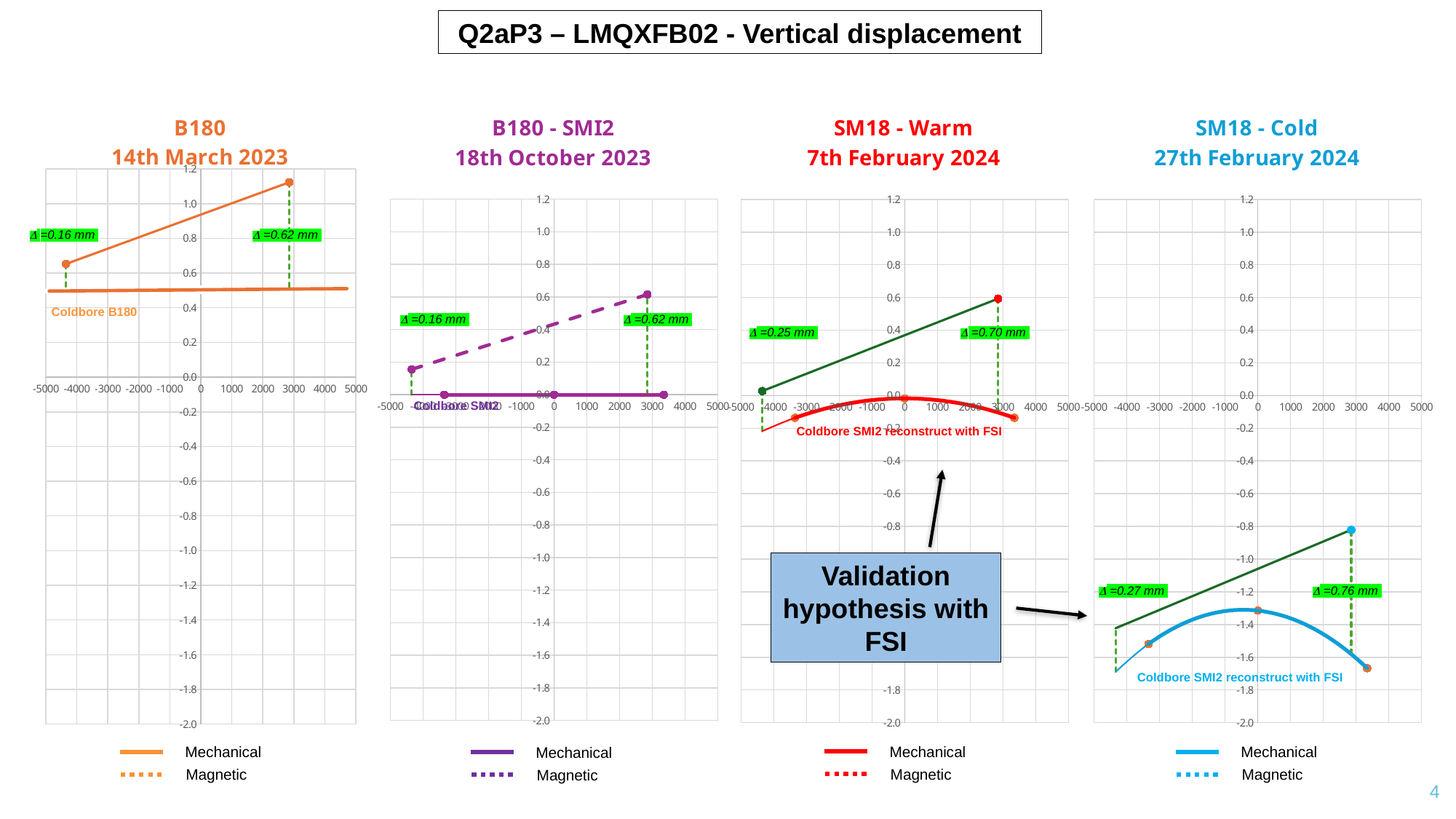
What kind of chart is the SM18 - Warm chart? Line chart In the SM18 - Warm chart, what is the Δ value printed on the right side? Δ =0.70 mm In the SM18 - Cold chart, what is the Δ value printed on the left side? Δ =0.27 mm In the SM18 - Warm chart, what is the Δ value printed on the left side? Δ =0.25 mm How many charts are shown on the slide? 4 In the B180 (14th March 2023) chart, what is the Δ value printed on the right side of the chart? Δ =0.62 mm In the B180 (14th March 2023) chart, what is the Δ value printed on the left side of the chart? Δ =0.16 mm How many series does the legend of the B180 - SMI2 chart list? 2 In the SM18 - Cold chart, what is the Δ value printed on the right side? Δ =0.76 mm Which chart shows the larger right-side Δ value, SM18 - Warm or SM18 - Cold? SM18 - Cold In the SM18 - Cold chart, what is the difference between the right Δ value and the left Δ value? 0.49 mm In the B180 (14th March 2023) chart, is the right endpoint of the orange line greater or less than 1.0? greater